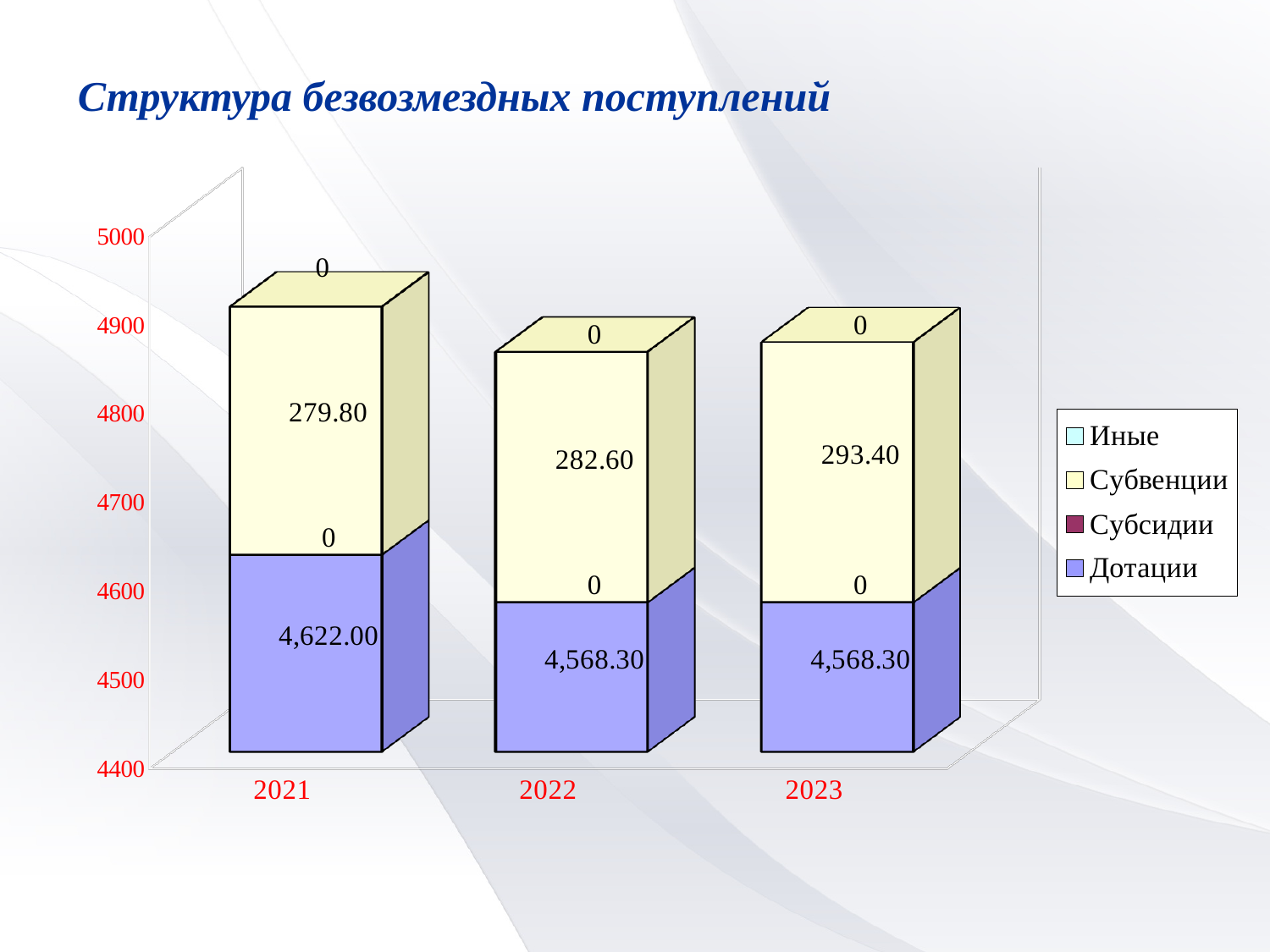
Is the Субвенции value for 2021 larger or smaller than the Субвенции value for 2022? smaller What is the value of Дотации for 2021? 4,622.00 What is the value of Субвенции for 2022? 282.60 What is the value of Субвенции for 2023? 293.40 What is the total of the stacked bar for 2021 (Дотации plus Субвенции)? 4,901.80 Which year has the highest value for Субвенции? 2023 What is the difference between the Дотации values for 2021 and 2022? 53.70 What kind of chart is shown on the slide? stacked bar chart Which year has the highest value for Дотации? 2021 How many series does the legend list? 4 What is the difference between the Субвенции values for 2023 and 2021? 13.60 How many years are shown on the x axis? 3